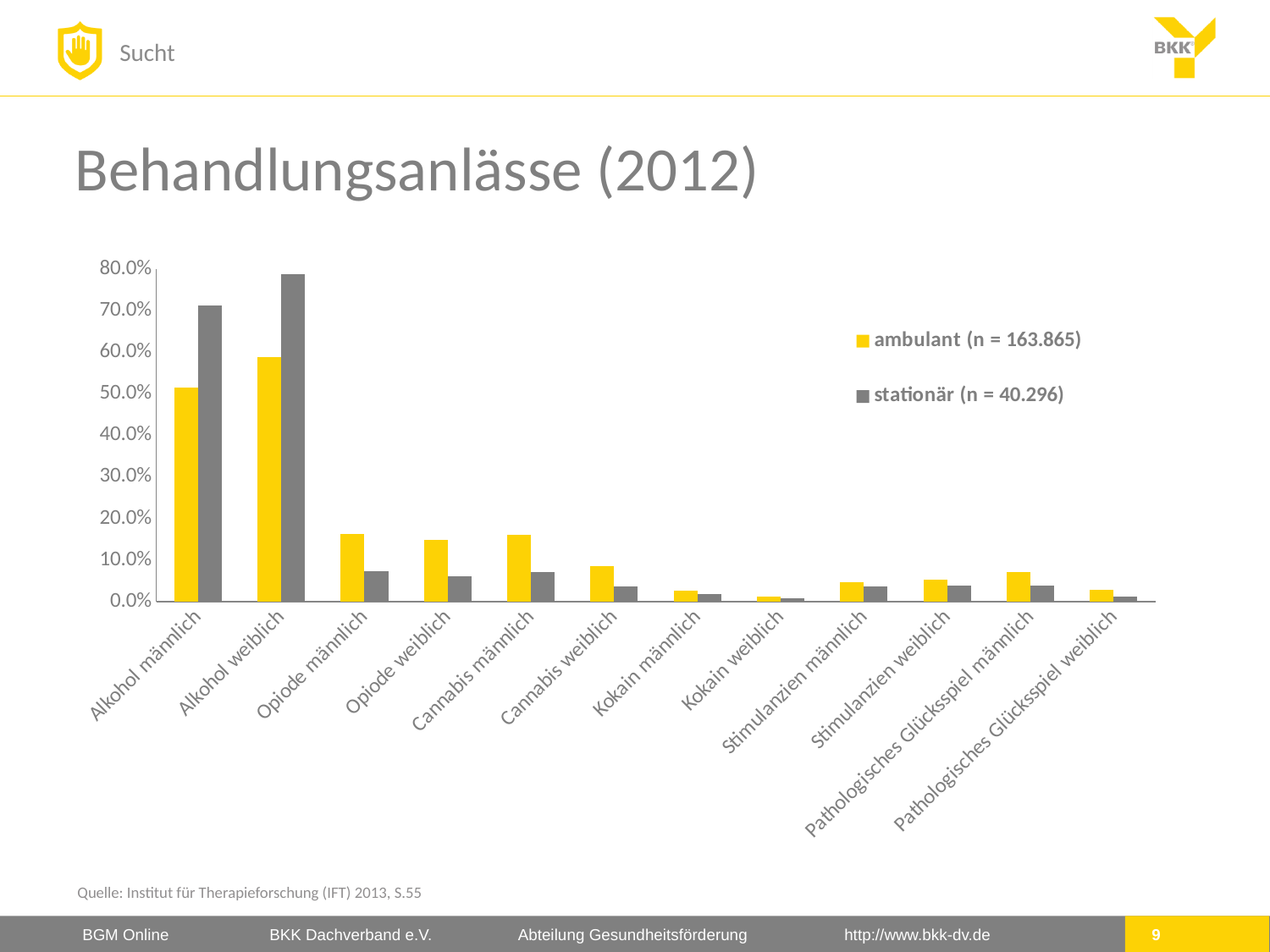
Is the ambulant value for Alkohol weiblich greater or less than 50.0%? greater How many series does the legend list? 2 How many categories are shown on the x axis? 12 Which category has the lowest value for the ambulant series? Kokain weiblich Is the stationär value for Cannabis weiblich greater or less than 10.0%? less Which category has the highest value for the ambulant series? Alkohol weiblich What kind of chart is shown on the slide? bar chart Which category has the highest value for the stationär series? Alkohol weiblich Is the ambulant value for Opiode männlich greater or less than 10.0%? greater For Alkohol männlich, which series has the larger value, ambulant or stationär? stationär For Opiode männlich, which series has the larger value, ambulant or stationär? ambulant